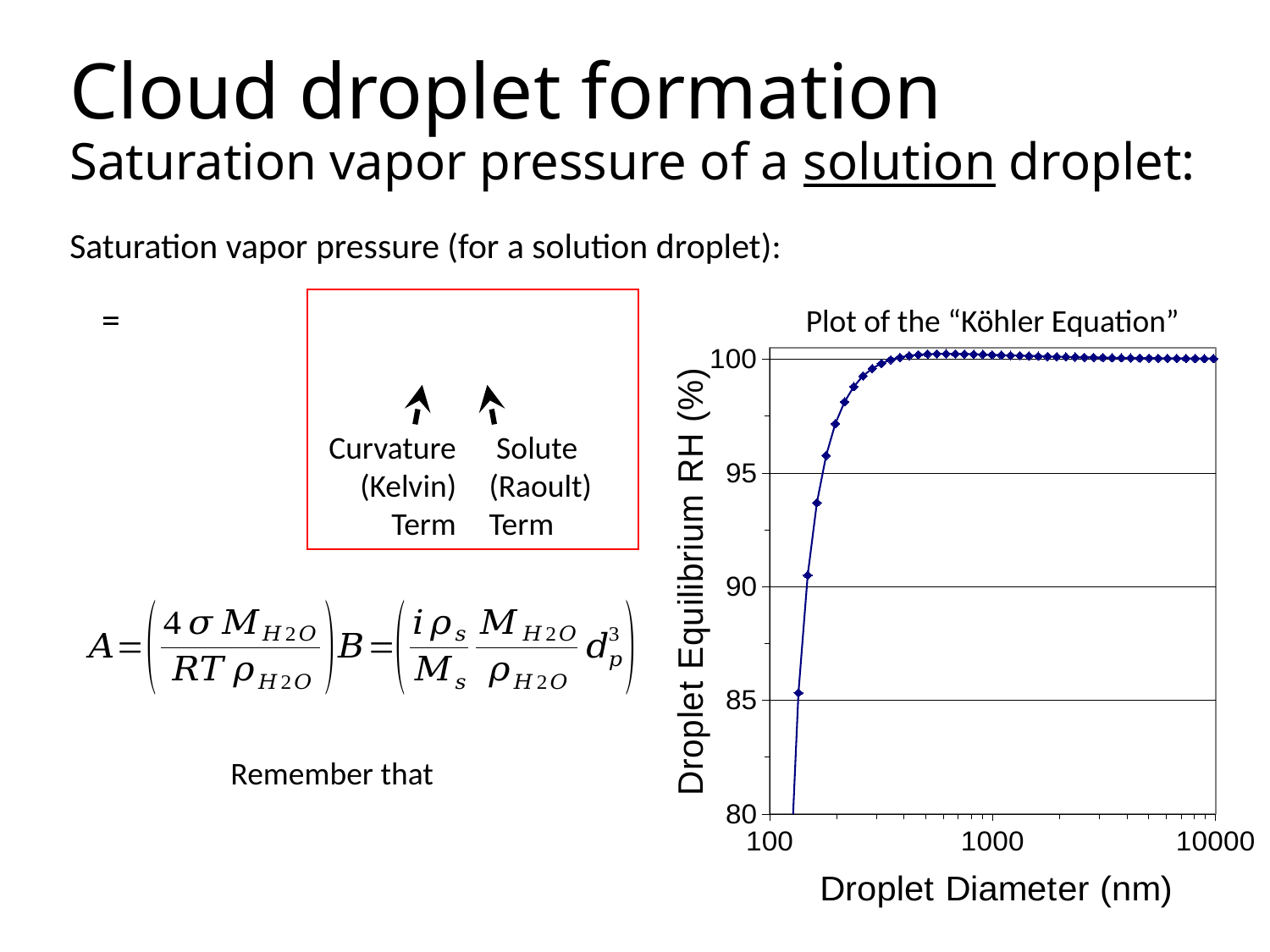
Is the Droplet Equilibrium RH at a Droplet Diameter of 10000 nm greater or less than 85? greater Is the Droplet Equilibrium RH at a Droplet Diameter of 10000 nm greater or less than 95? greater What is the label of the x axis of the chart? Droplet Diameter (nm) Which has the higher Droplet Equilibrium RH: a Droplet Diameter of 1000 nm or the leftmost plotted point near 100 nm? 1000 nm Is the Droplet Equilibrium RH at a Droplet Diameter of 1000 nm greater or less than 95? greater What is the title of the chart on the slide? Plot of the "Köhler Equation" Does the Droplet Equilibrium RH rise or fall as Droplet Diameter increases along the x axis? rise What kind of chart is the "Plot of the "Köhler Equation""? line chart